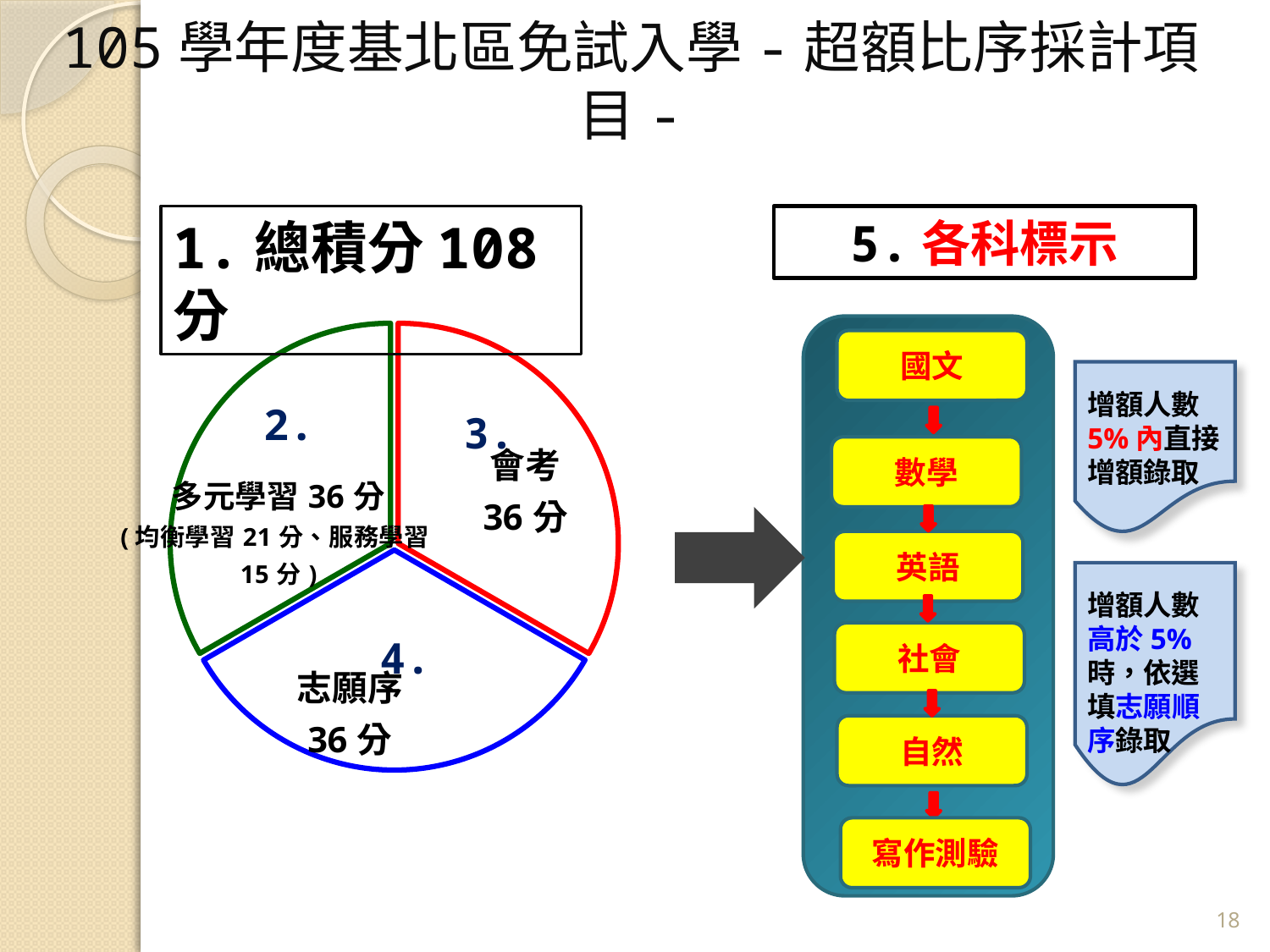
What is the total of the three slices in the pie chart (總積分)? 108 分 Which colour outlines the 志願序 slice of the pie chart? blue Which colour outlines the 會考 slice of the pie chart? red What share of the 108-point total does the 會考 slice represent? one third (36 of 108) According to the pie chart label, how many points is 均衡學習 worth within 多元學習? 21 分 What kind of chart is shown on the left of the slide? pie chart What value is shown for the 多元學習 slice of the pie chart? 36 分 According to the pie chart label, how many points is 服務學習 worth within 多元學習? 15 分 What is the difference between the 會考 value and the 志願序 value in the pie chart? 0 分 What value is shown for the 會考 slice of the pie chart? 36 分 How many slices does the pie chart have? 3 What value is shown for the 志願序 slice of the pie chart? 36 分